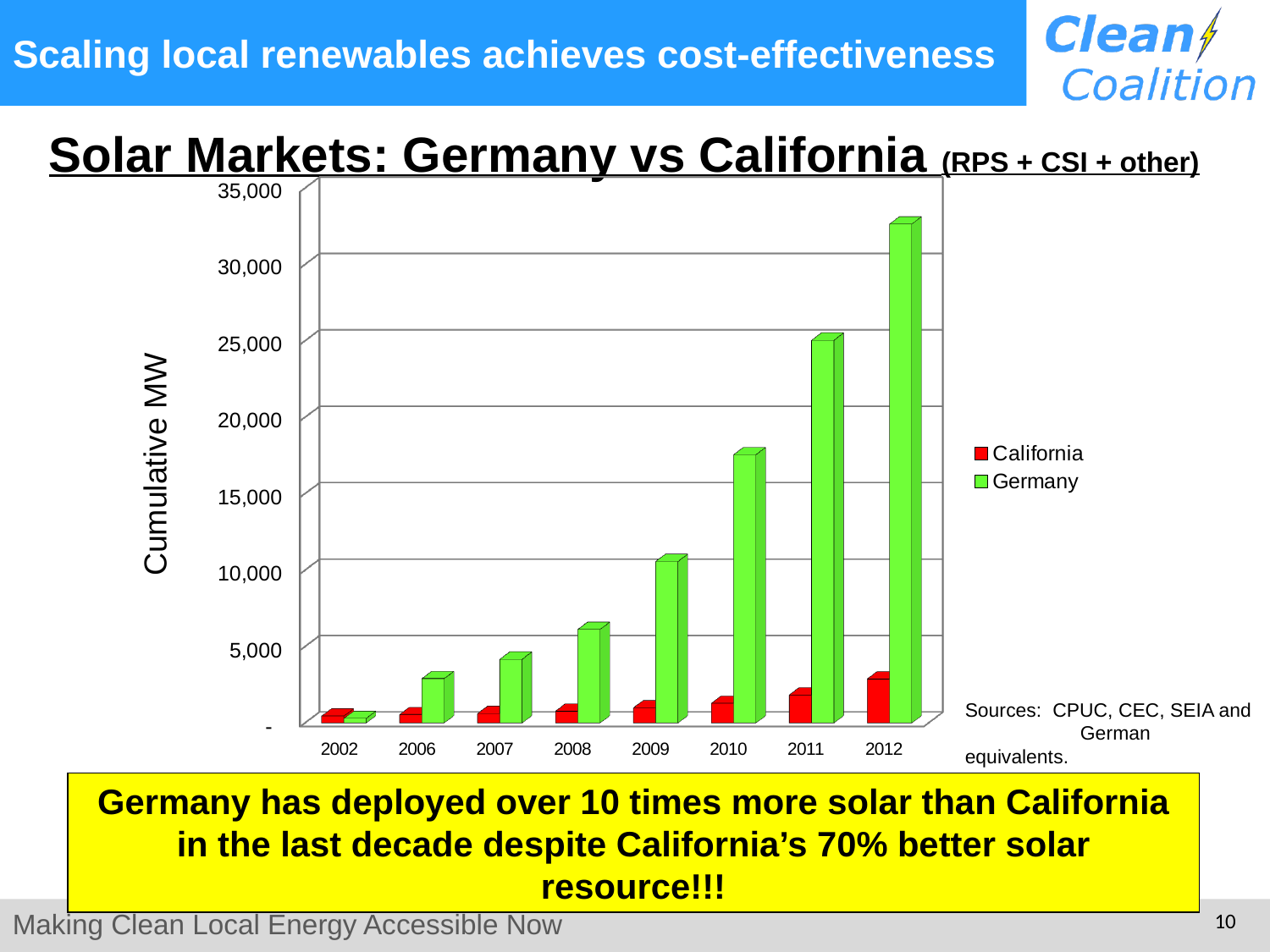
Is the value for Germany in 2007 greater or less than 5,000? less What kind of chart is shown on the slide? bar chart Is the value for California in 2012 greater or less than 5,000? less Is the value for Germany in 2012 greater or less than 30,000? greater How many series does the legend list? 2 What is the label on the y axis of the chart? Cumulative MW In which year is the Germany bar lowest? 2002 Do the Germany values rise or fall from 2002 to 2012? rise In 2012, which is larger: the Germany value or the California value? Germany How many years are shown along the x axis? 8 In which year is the Germany bar highest? 2012